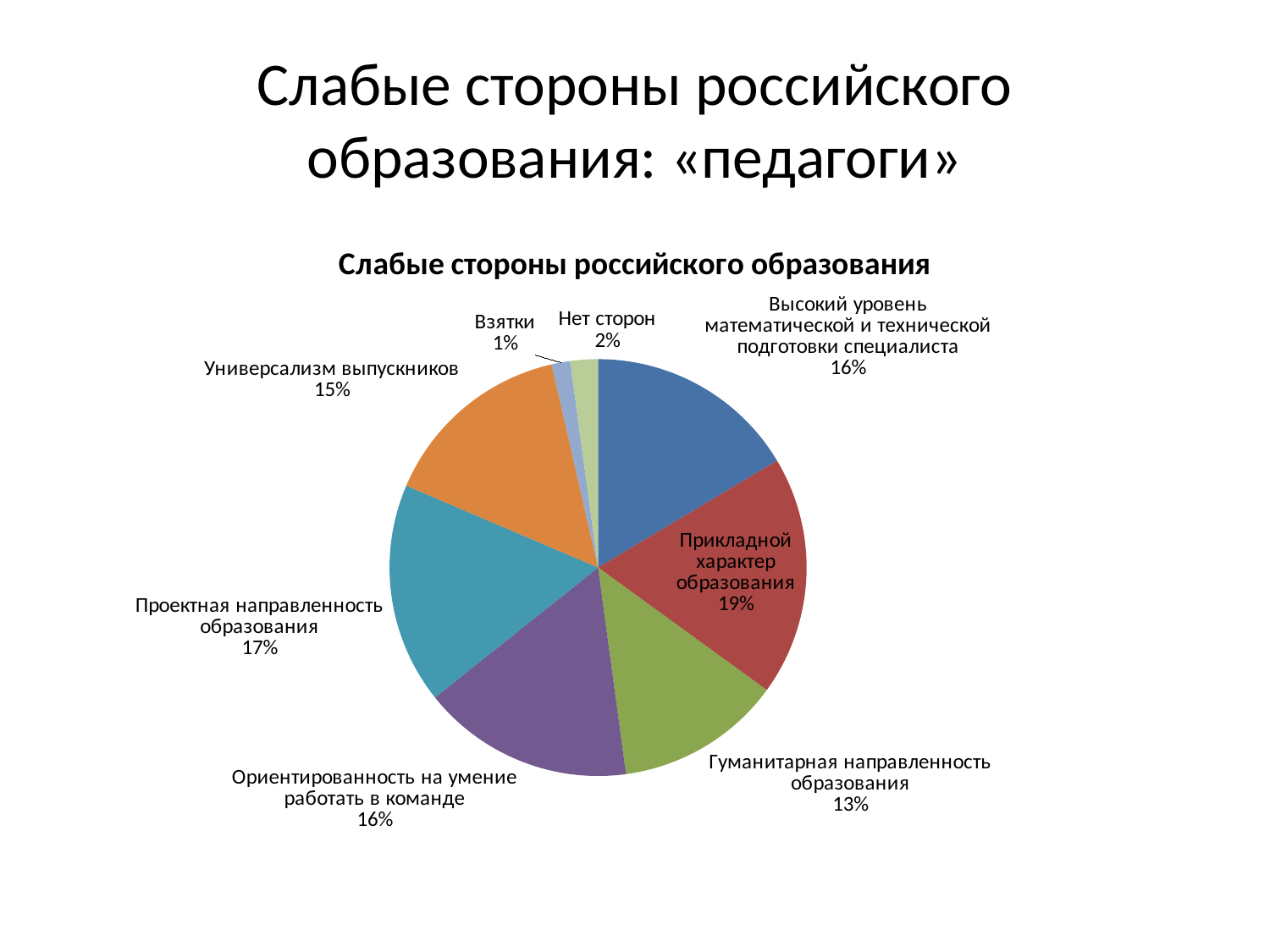
How many slices does the pie chart have? 8 What share does "Прикладной характер образования" have? 19% What share does "Взятки" have? 1% What is the title of the chart? Слабые стороны российского образования Which category has the largest share of the pie? Прикладной характер образования Which is larger: the share for "Проектная направленность образования" or for "Гуманитарная направленность образования"? Проектная направленность образования What type of chart is shown on the slide? Pie chart What share does "Гуманитарная направленность образования" have? 13% What is the difference in percentage points between "Прикладной характер образования" and "Универсализм выпускников"? 4 Which category has the smallest share of the pie? Взятки